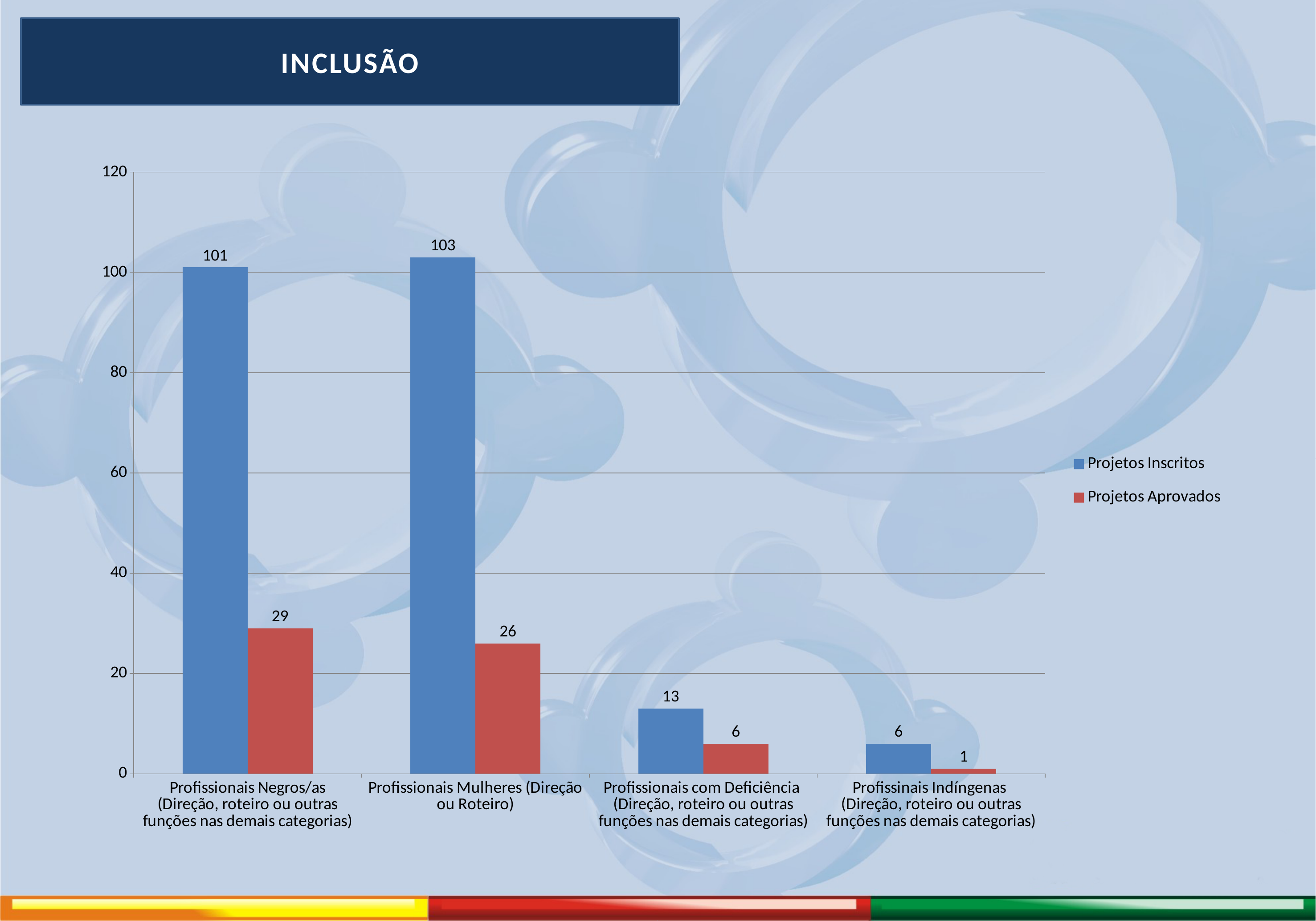
Which is larger: Projetos Aprovados for Profissionais Negros/as or for Profissionais Mulheres? Profissionais Negros/as How many Projetos Aprovados are shown for Profissionais Mulheres (Direção ou Roteiro)? 26 What kind of chart is shown on the slide? Bar chart How many Projetos Inscritos are shown for Profissionais Negros/as? 101 What is the difference between Projetos Inscritos and Projetos Aprovados for Profissionais Negros/as? 72 How many Projetos Inscritos are shown for Profissionais com Deficiência? 13 Which category has the highest number of Projetos Inscritos? Profissionais Mulheres (Direção ou Roteiro) How many categories are shown on the x axis? 4 How many series does the legend list? 2 Which category has the lowest number of Projetos Aprovados? Profissinais Indígenas How many Projetos Aprovados are shown for Profissinais Indígenas? 1 What is the title shown in the box at the top of the slide? INCLUSÃO